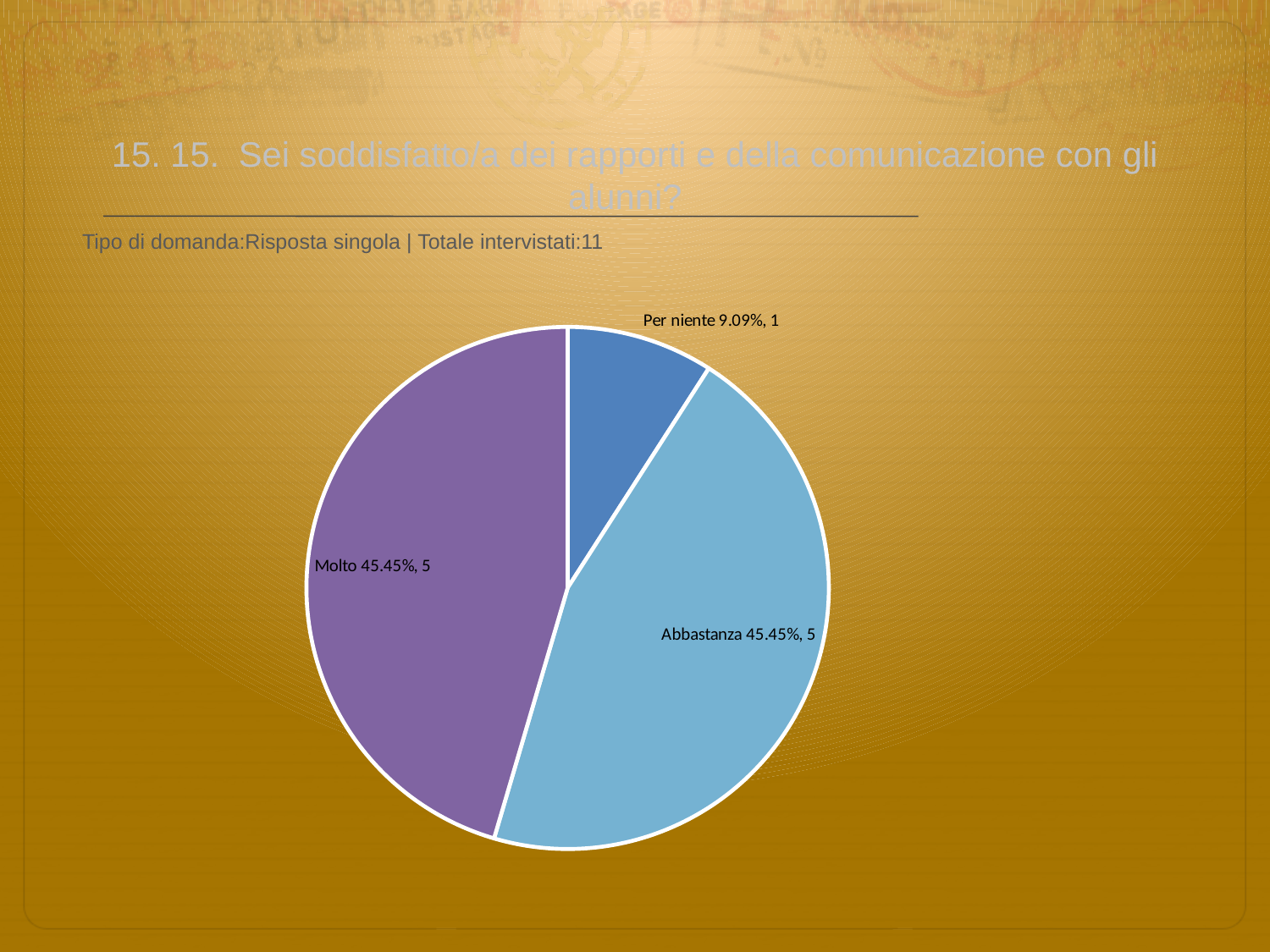
What percentage share does the 'Per niente' slice have? 9.09% How many respondents chose 'Per niente'? 1 Which is larger, the 'Molto' slice or the 'Per niente' slice? Molto What kind of chart is shown on the slide? pie chart What colour is the 'Molto' slice? purple Which category has the smallest slice of the pie? Per niente What is the total number of respondents shown across all slices? 11 How many slices does the pie chart have? 3 Is the share for 'Abbastanza' greater or less than 50%? less What percentage share does the 'Molto' slice have? 45.45% What is the difference in respondent count between 'Abbastanza' and 'Per niente'? 4 How many respondents chose 'Abbastanza'? 5